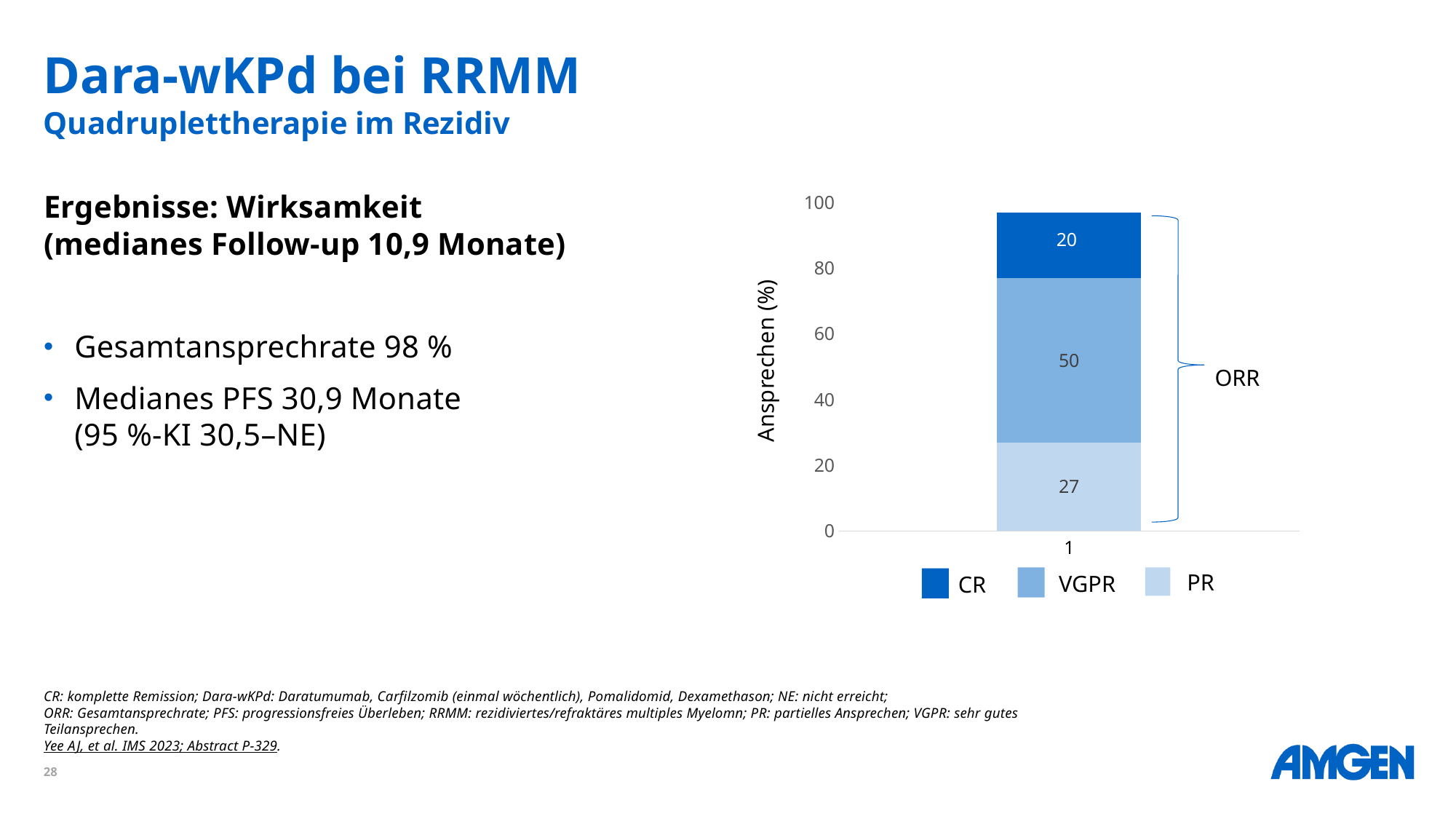
What is the label of the y axis? Ansprechen (%) How many series does the legend list? 3 What is the value of the VGPR segment in the stacked bar? 50 Which series has the largest segment in the stacked bar? VGPR What label is shown next to the bracket spanning the whole stacked bar? ORR Which series has the smallest segment in the stacked bar? CR What is the value of the PR segment in the stacked bar? 27 What kind of chart is shown on the slide? Stacked bar chart What is the difference between the VGPR and PR segment values? 23 Which is larger, the PR segment or the CR segment? PR What is the value of the CR segment in the stacked bar? 20 What is the total of the stacked bar (CR + VGPR + PR)? 97